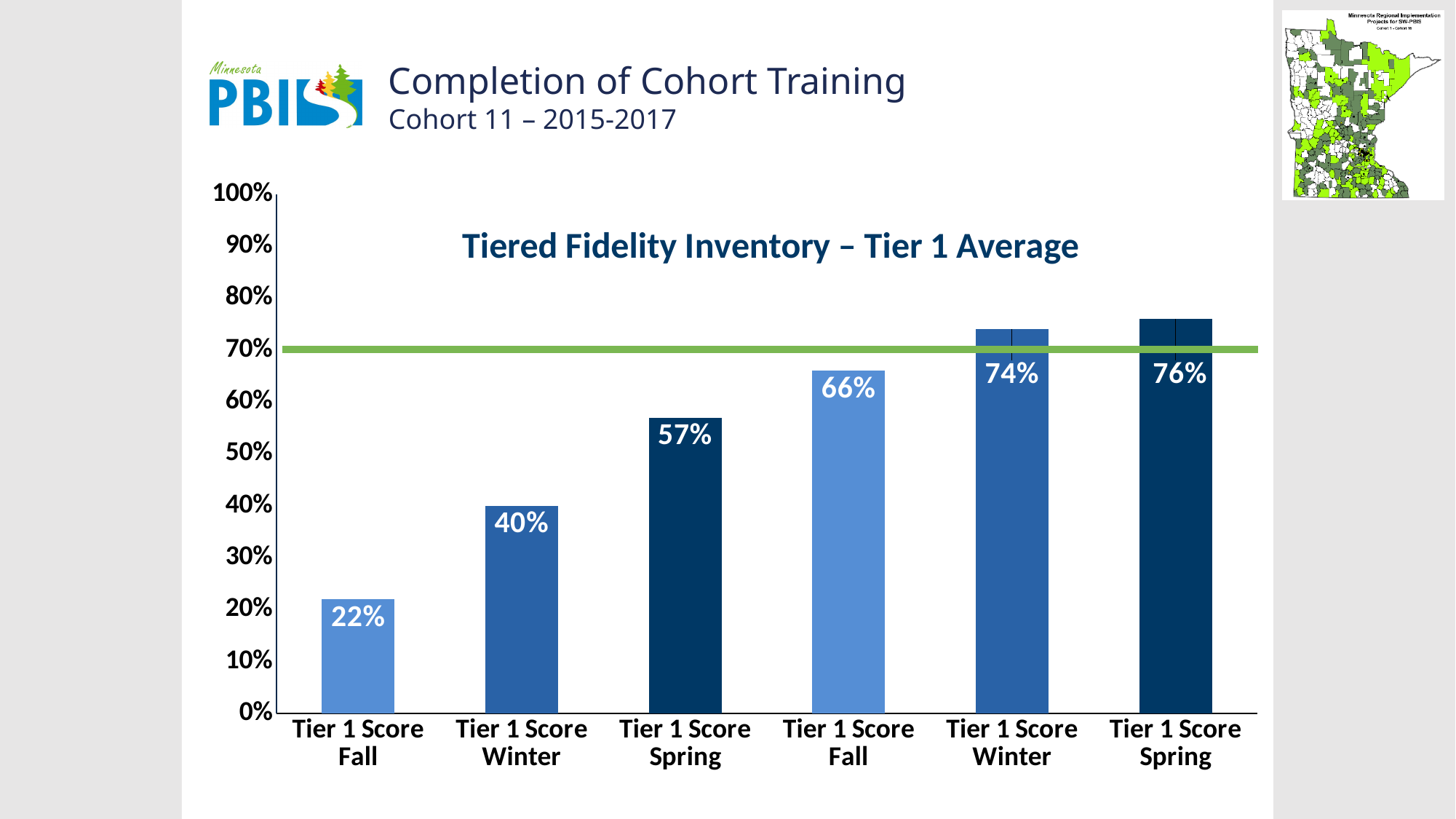
What is the difference between the rightmost Tier 1 Score Spring bar (76%) and the leftmost Tier 1 Score Fall bar (22%)? 54% What is the title of the chart? Tiered Fidelity Inventory – Tier 1 Average What type of chart is shown on the slide? bar chart What is the value of the first Tier 1 Score Winter bar (second from left)? 40% What is the value of the rightmost bar, the second Tier 1 Score Spring? 76% What is the value of the first Tier 1 Score Spring bar (third from left)? 57% What is the value of the first bar, Tier 1 Score Fall (leftmost)? 22% How many bars are plotted in the chart? 6 Do the bar values rise or fall from left to right across the chart? rise Which bar has the lowest value? Tier 1 Score Fall (leftmost), 22% What is the value of the second Tier 1 Score Fall bar (fourth from left)? 66% At what value on the y axis is the horizontal green line drawn? 70%